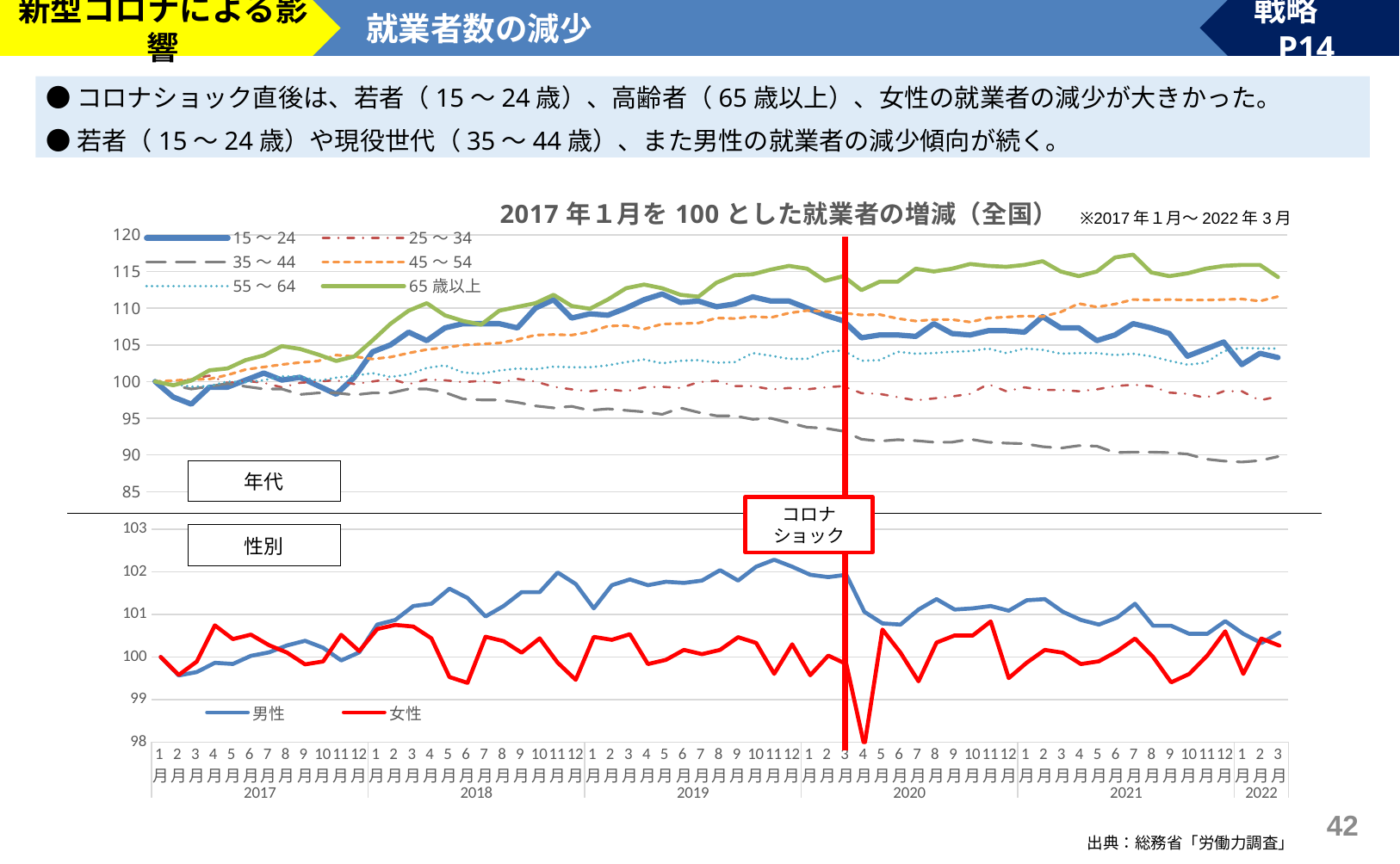
What label is attached to the red vertical line crossing both charts? コロナショック How many series does the legend of the upper chart (年代) list? 6 In the upper chart (年代), is the value for 35～44 at 2022年3月 greater or less than 95? less In the lower chart (性別), is the value for 女性 at 2020年4月 greater or less than 99? less In the upper chart (年代), does the 35～44 series rise or fall overall from 2017年1月 to 2022年3月? fall In the upper chart (年代), which series has the lowest value at 2022年3月? 35～44 In the upper chart (年代), which series has the highest value at 2022年3月? 65歳以上 What kind of chart is the upper chart (年代) on the slide? line chart What is the title of the upper chart on the slide? 2017年1月を100とした就業者の増減（全国） How many series does the legend of the lower chart (性別) list? 2 In the upper chart (年代), is the value for 65歳以上 at 2022年3月 greater or less than 110? greater In the upper chart (年代), which is larger at 2021年1月: the value for 65歳以上 or the value for 25～34? 65歳以上